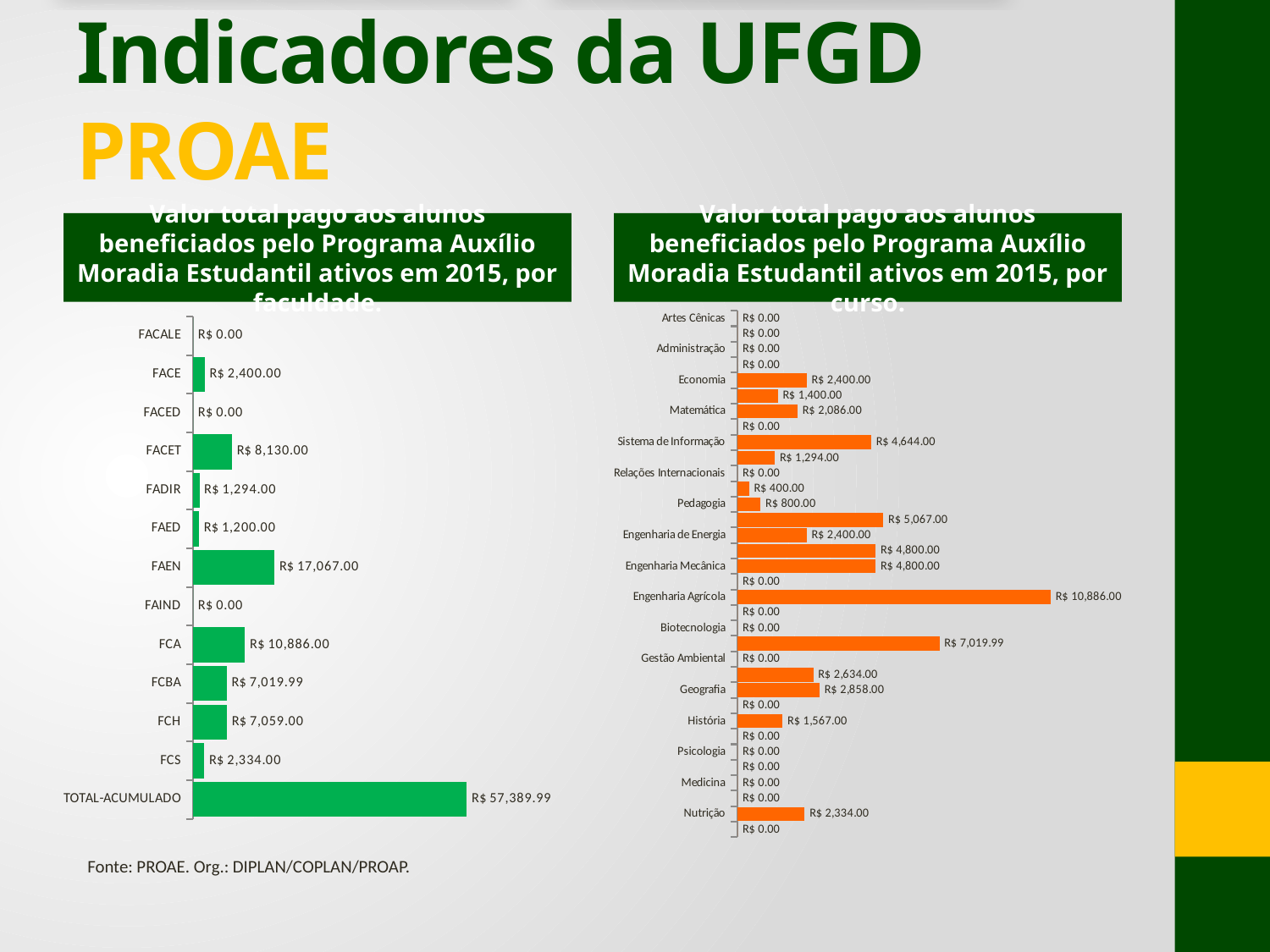
In the left chart (by faculdade), what is the difference between the values for FAEN and FCA? R$ 6,181.00 In the left chart (by faculdade), what is the difference between the values for FCA and FCBA? R$ 3,866.01 What kind of chart is the left chart (by faculdade)? Bar chart What colour are the bars in the right chart (by curso)? Orange In the left chart (by faculdade), which faculdade (excluding TOTAL-ACUMULADO) has the highest value? FAEN In the left chart (by faculdade), what is the value for FAEN? R$ 17,067.00 In the left chart (by faculdade), what is the value for FACET? R$ 8,130.00 In the right chart (by curso), what is the largest value labelled on any bar? R$ 10,886.00 What colour are the bars in the left chart (by faculdade)? Green In the left chart (by faculdade), which is larger, the value for FACET or the value for FCS? FACET In the left chart (by faculdade), what is the value shown for TOTAL-ACUMULADO? R$ 57,389.99 How many categories are shown on the left chart (by faculdade), including TOTAL-ACUMULADO? 13